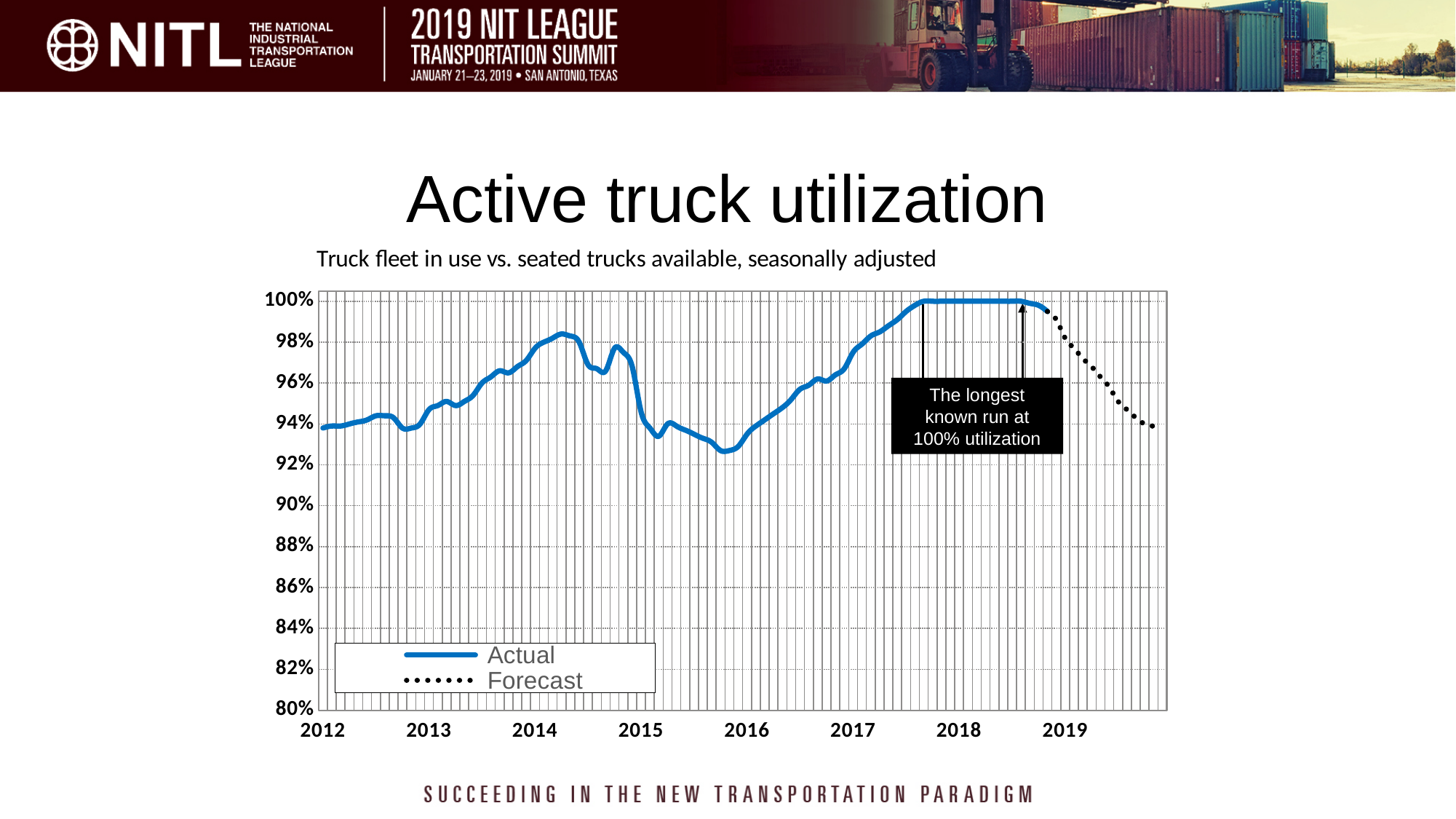
Is the Forecast value at the end of 2019 greater or less than 96%? less Does the Forecast series rise or fall across 2019? fall What kind of chart is shown on the slide? line chart Is the Actual value at the start of 2012 greater or less than 92%? greater Is the Actual value higher at the start of 2014 or at the start of 2016? 2014 How many series does the legend list? 2 Is the Actual value at the start of 2016 greater or less than 94%? less Which series is drawn as a dotted line? Forecast According to the annotation on the chart, at what utilization level was the longest known run? 100% What are the two series named in the legend? Actual and Forecast Does the Actual series rise or fall from the start of 2016 to the start of 2018? rise